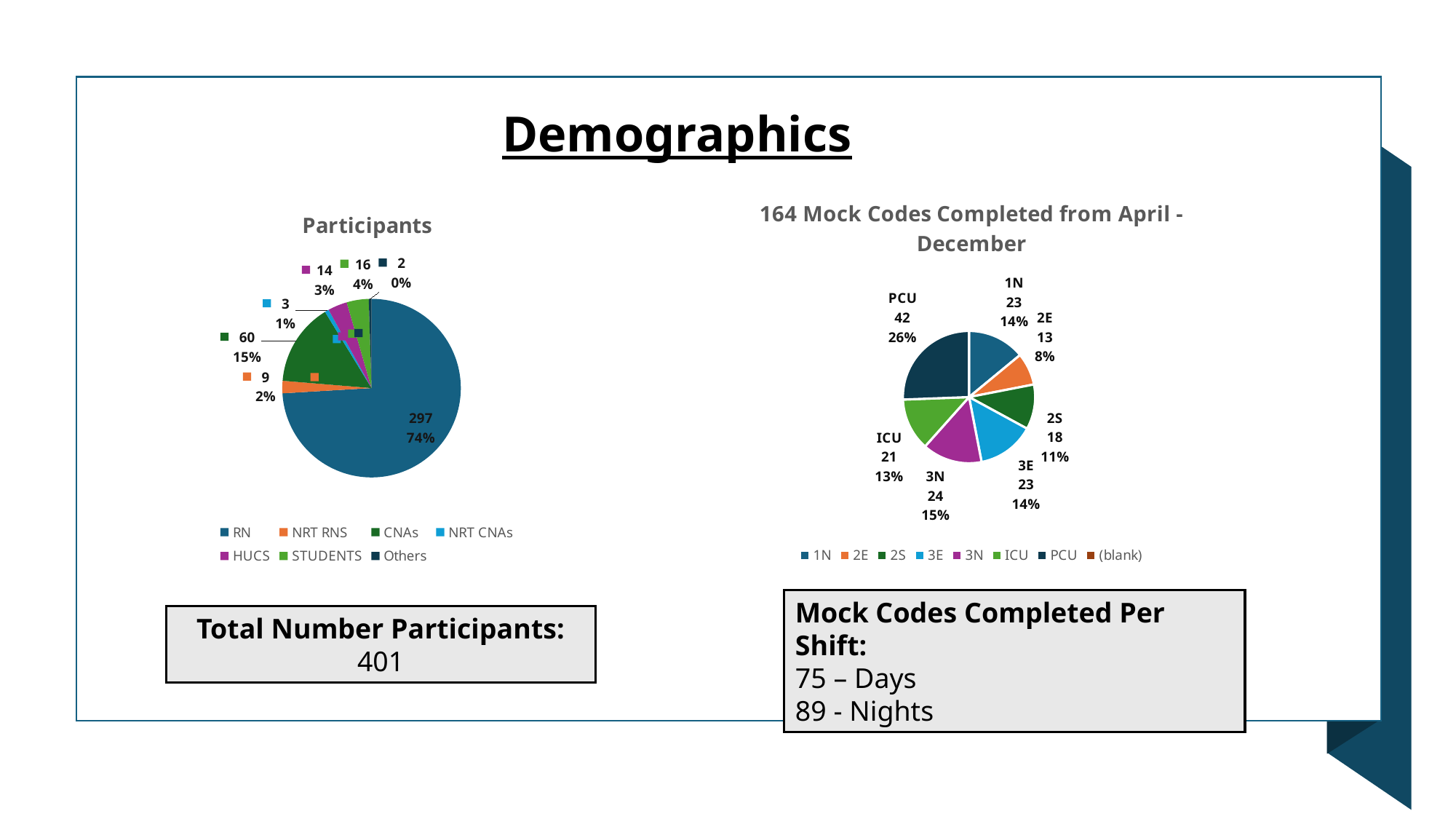
How many entries does the legend of the 164 Mock Codes Completed from April - December chart list? 8 In the 164 Mock Codes Completed from April - December chart, which unit has the smallest value? 2E In the 164 Mock Codes Completed from April - December chart, what is the value for PCU? 42 What type of chart is the Participants chart? Pie chart In the Participants chart, which category has the smallest value? Others In the Participants chart, which is larger, STUDENTS or NRT RNS? STUDENTS In the Participants chart, what percentage share does CNAs have? 15% In the 164 Mock Codes Completed from April - December chart, what is the difference between PCU and ICU? 21 In the Participants chart, what is the value for RN? 297 In the Participants chart, which category has the largest slice? RN In the 164 Mock Codes Completed from April - December chart, what percentage share does 3N have? 15% In the Participants chart, what is the difference between the CNAs value and the HUCS value? 46